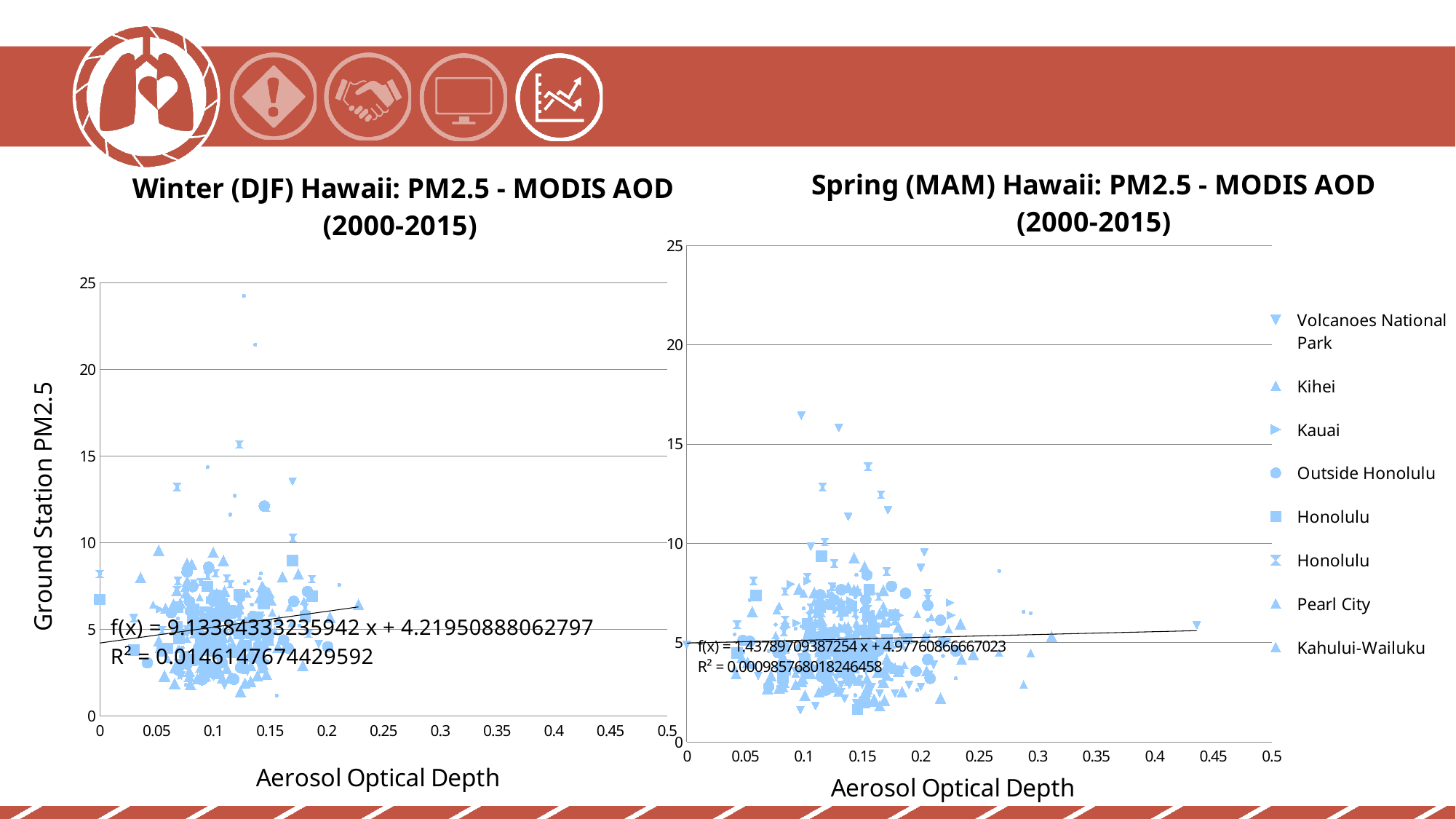
On the Winter (DJF) Hawaii chart, does the trendline rise or fall as Aerosol Optical Depth increases? rise How many series does the legend on the Spring (MAM) Hawaii chart list? 8 Which chart has the steeper trendline slope, the Winter (DJF) chart or the Spring (MAM) chart? Winter (DJF) What kind of chart is the Winter (DJF) Hawaii: PM2.5 - MODIS AOD (2000-2015) chart? scatter chart What is the y-axis label on the Winter (DJF) Hawaii chart? Ground Station PM2.5 On the Spring (MAM) Hawaii chart, what is the trendline equation shown? f(x) = 1.43789709387254 x + 4.97760866667023 On the Winter (DJF) Hawaii chart, what is the R² value shown for the trendline? R² = 0.0146147674429592 On the Spring (MAM) Hawaii chart, what is the R² value shown for the trendline? R² = 0.000985768018246458 What is the x-axis label on the Spring (MAM) Hawaii chart? Aerosol Optical Depth On the Winter (DJF) Hawaii chart, is the highest plotted PM2.5 value greater or less than 20? greater On the Winter (DJF) Hawaii chart, what is the trendline equation shown? f(x) = 9.13384333235942 x + 4.21950888062797 On the Spring (MAM) Hawaii chart, is the highest plotted PM2.5 value greater or less than 20? less